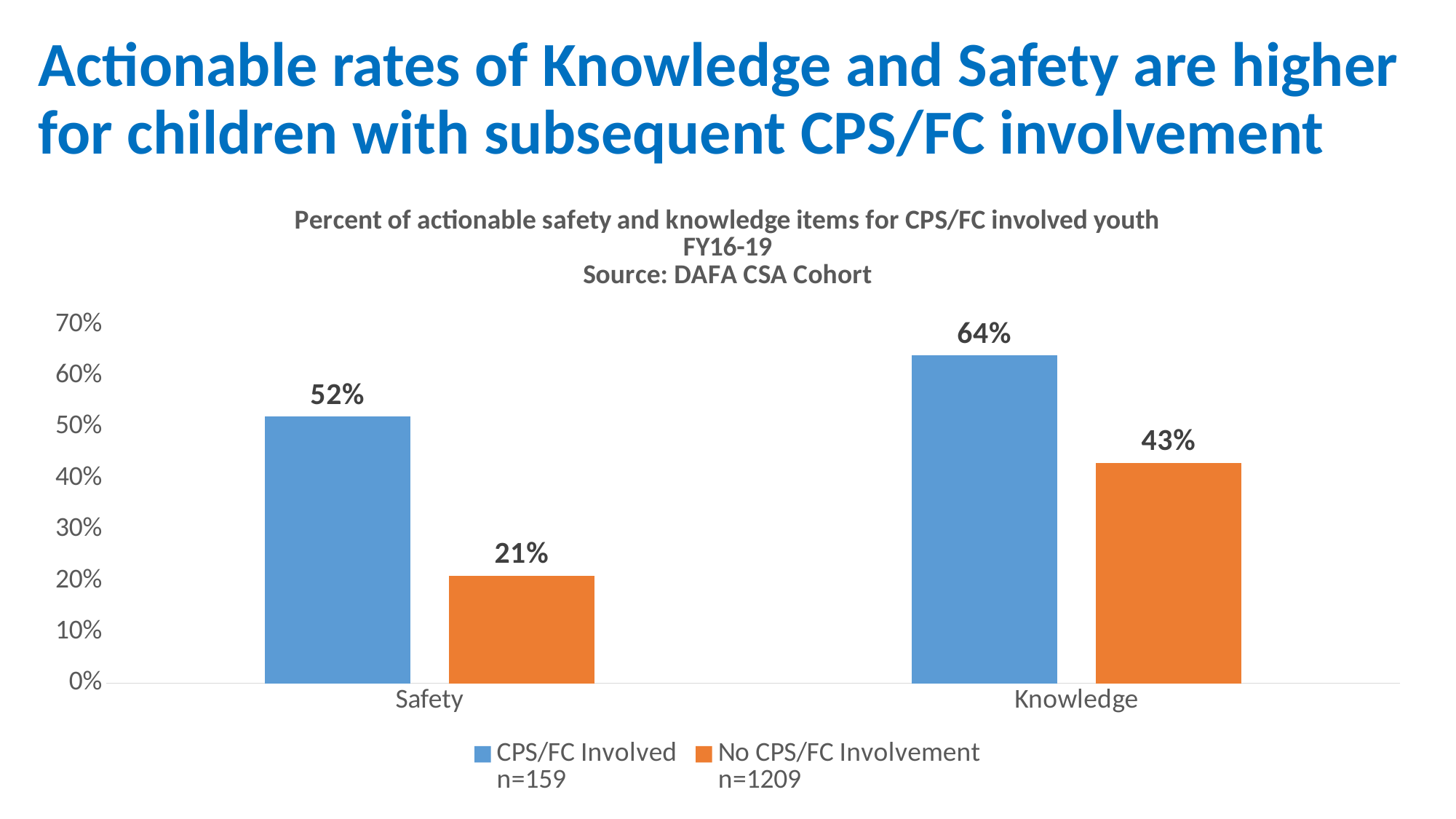
What is the difference between the CPS/FC Involved and No CPS/FC Involvement values for Knowledge? 21% What kind of chart is shown on the slide? Bar chart Which bar has the highest value on the chart? CPS/FC Involved, Knowledge Which is larger: the CPS/FC Involved value for Safety or the No CPS/FC Involvement value for Knowledge? CPS/FC Involved value for Safety What is the difference between the CPS/FC Involved and No CPS/FC Involvement values for Safety? 31% How many series does the legend list? 2 What is the sample size (n) for the No CPS/FC Involvement series shown in the legend? n=1209 What is the value for No CPS/FC Involvement in the Knowledge category? 43% How many categories are shown on the x axis? 2 What is the value for No CPS/FC Involvement in the Safety category? 21% Which bar has the lowest value on the chart? No CPS/FC Involvement, Safety What is the value for CPS/FC Involved in the Safety category? 52%